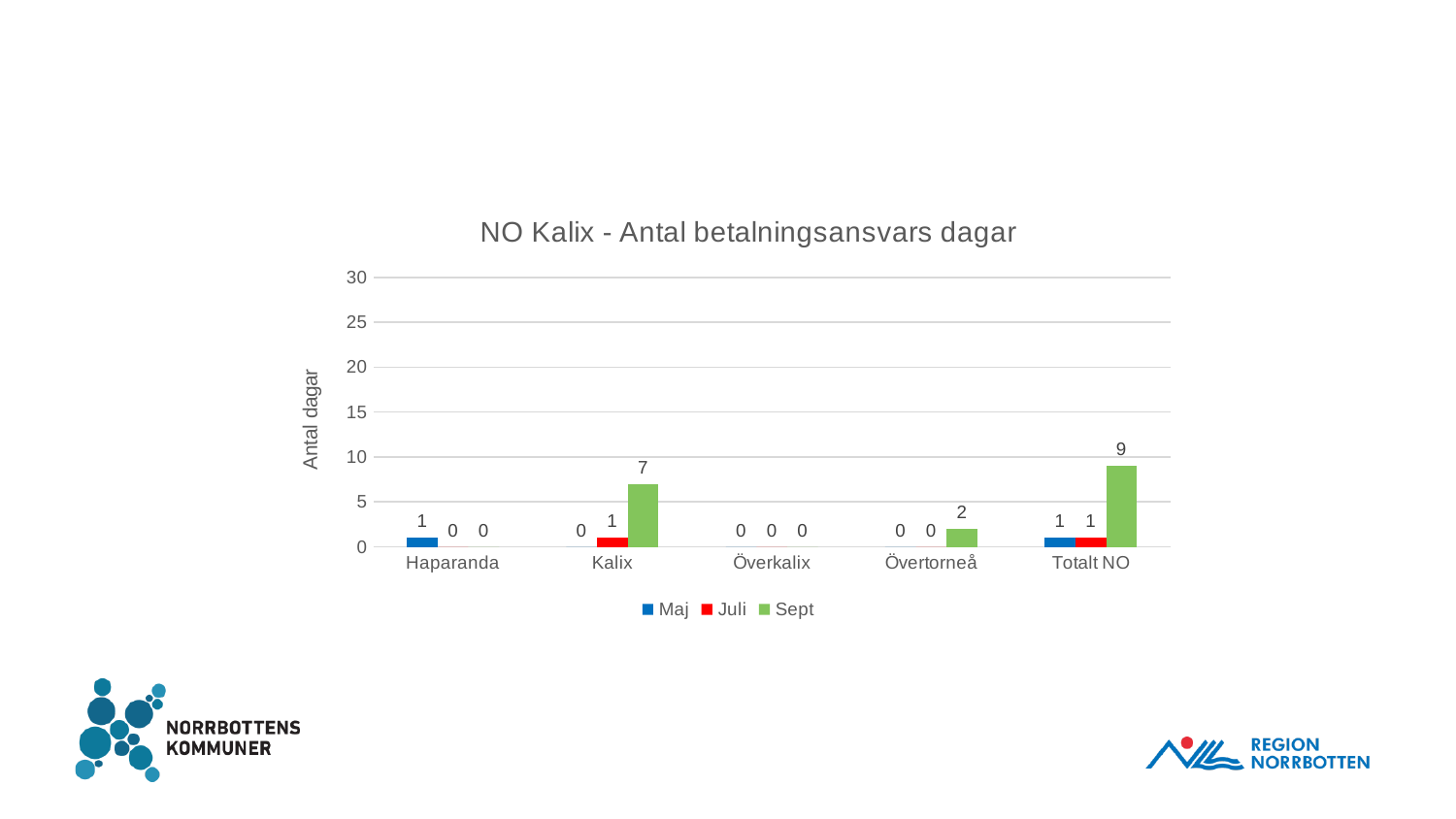
Is the Sept value for Totalt NO greater or less than 10? less What is the Maj value for Haparanda? 1 What is the Sept value for Övertorneå? 2 What is the Sept value for Totalt NO? 9 What is the Sept value for Kalix? 7 What kind of chart is shown? bar chart What is the title of the chart? NO Kalix - Antal betalningsansvars dagar How many series does the legend list? 3 What is the difference between the Sept values for Totalt NO and Kalix? 2 Which category has the highest Sept value? Totalt NO How many categories are shown on the x axis? 5 Which is larger, the Sept value for Kalix or the Sept value for Övertorneå? Kalix